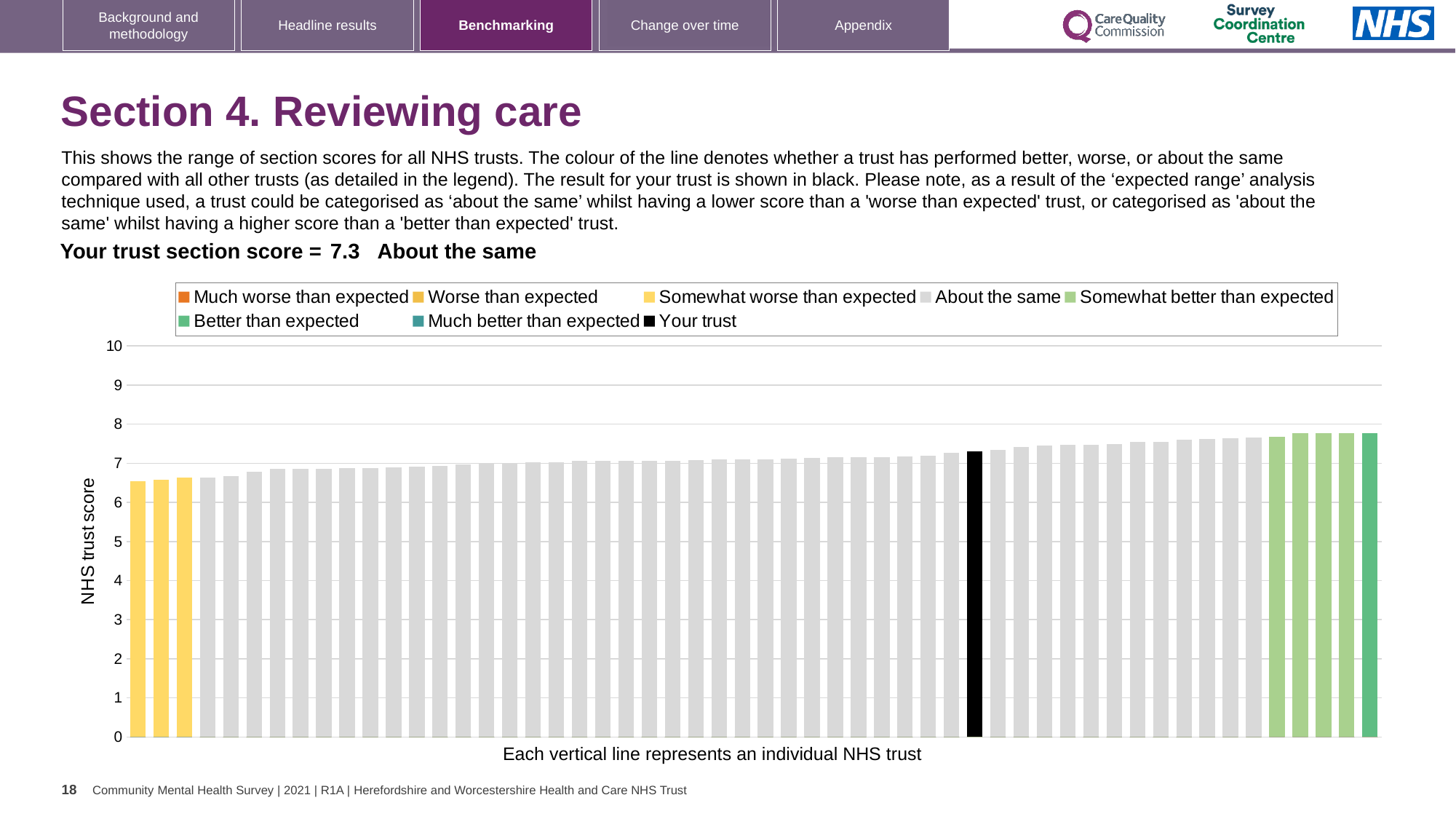
Is the value of the black 'Your trust' bar greater or less than 8? less Is the value of the black 'Your trust' bar greater or less than 7? greater Is the value of the lowest bar in the chart greater or less than 6? greater What category is your trust's section score placed in, according to the slide? About the same What is the section score for your trust shown on the slide? 7.3 How many yellow bars are there at the left of the chart? 3 What is the label on the vertical axis of the chart? NHS trust score How many entries does the chart legend list? 8 Do the bar values rise or fall from left to right along the x axis? rise What kind of chart is shown on the slide? bar chart